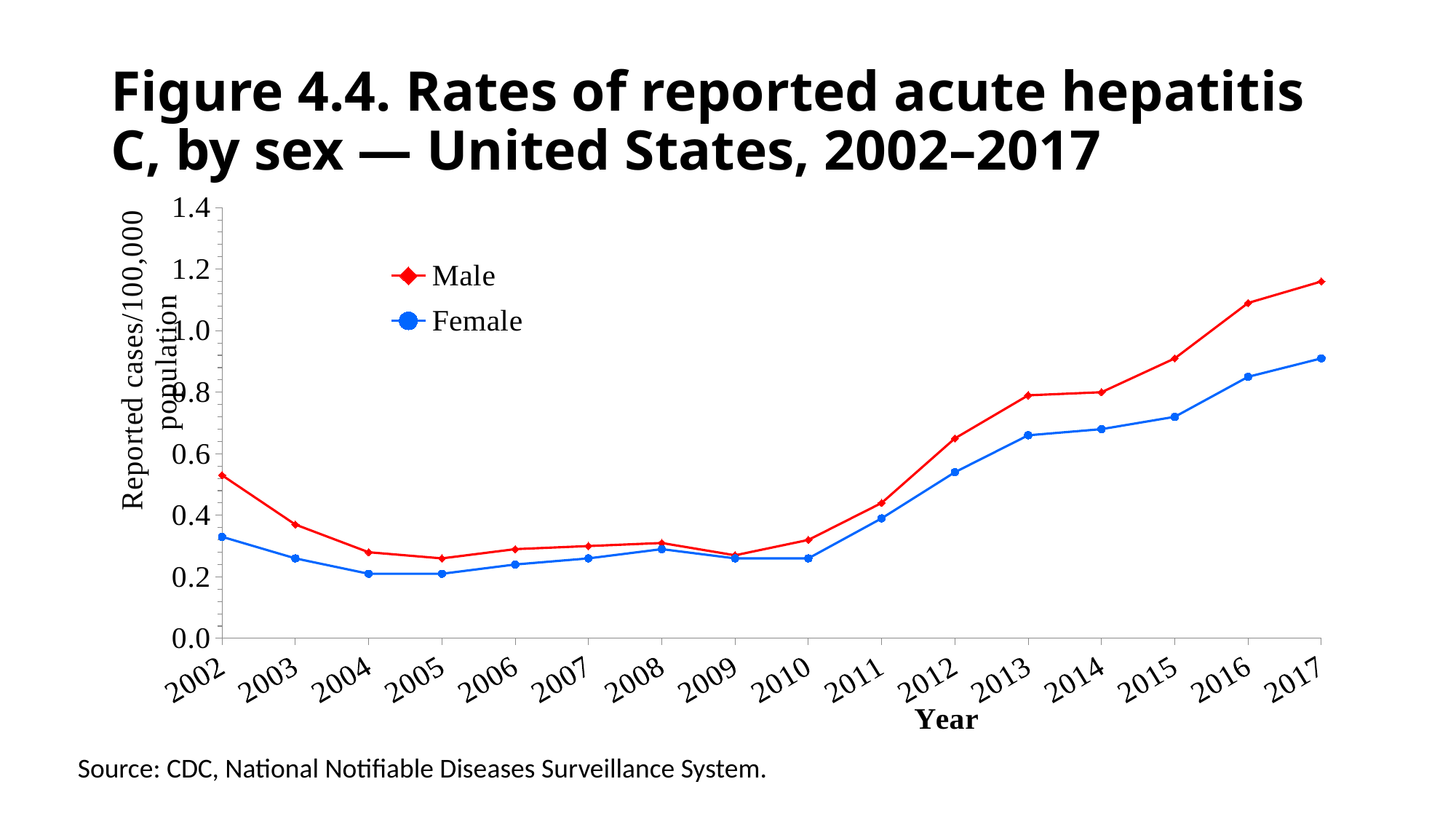
What kind of chart is shown on the slide? line chart Which series has the higher value in 2016, Male or Female? Male How many years are plotted along the x axis? 16 In which year is the Male rate highest? 2017 Do the Male and Female rates rise or fall from 2010 to 2017? rise How many series does the legend list? 2 Is the Female value for 2017 greater or less than 1.0? less In which year is the Female rate highest? 2017 Is the Female value for 2012 greater or less than 0.6? less What colour is the Female line? blue Is the Male value for 2002 greater or less than 0.6? less